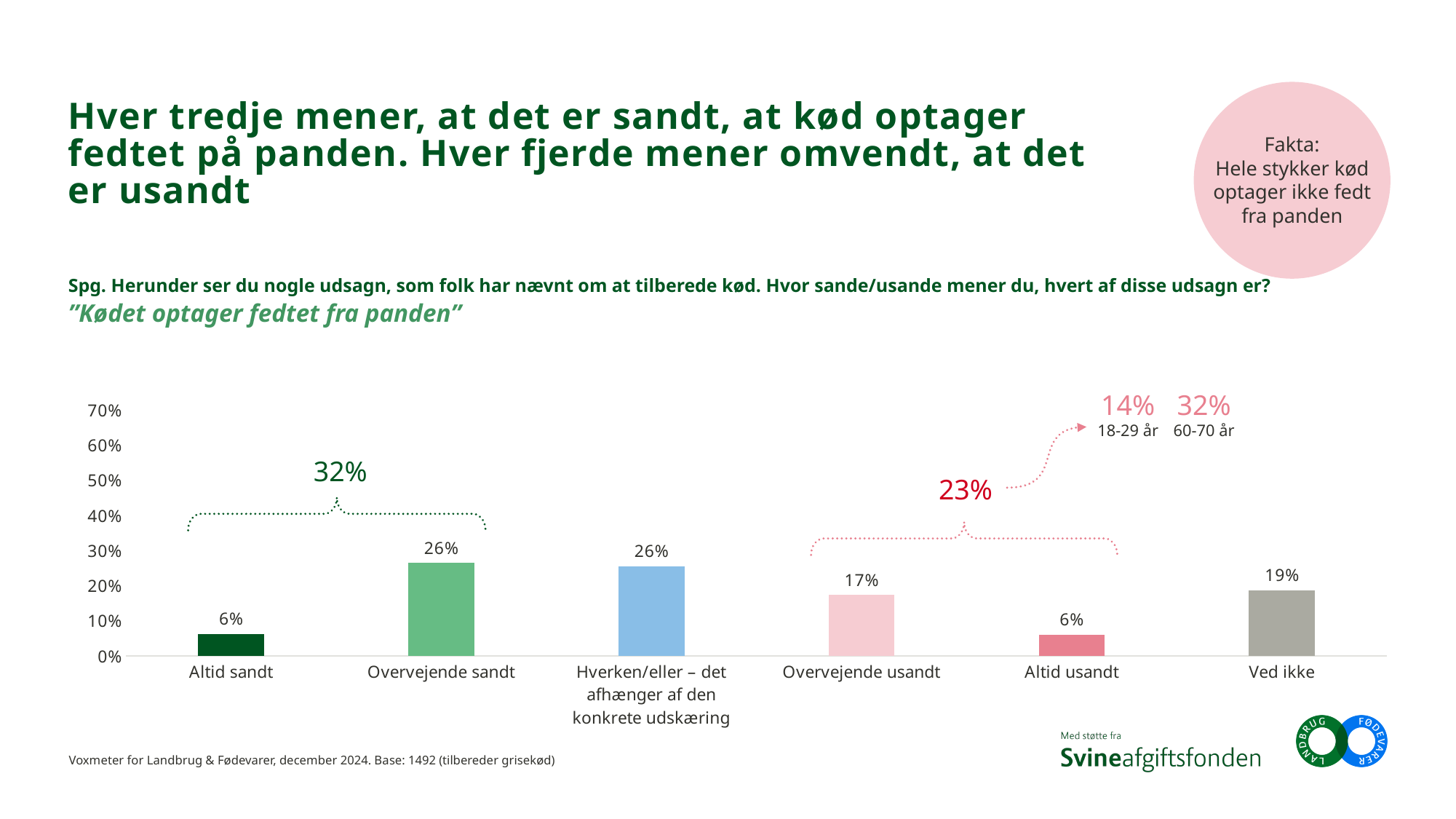
How many categories are shown on the x axis of the chart? 6 What is the value for "Altid sandt"? 6% What is the value for "Altid usandt"? 6% What is the difference between the values for "Ved ikke" and "Overvejende usandt"? 2 percentage points What is the combined value of "Altid sandt" and "Overvejende sandt" as shown by the bracket annotation? 32% Which is larger, the value for "Ved ikke" or the value for "Overvejende usandt"? Ved ikke What is the value for "Overvejende sandt"? 26% Is the value for "Overvejende usandt" greater or less than 20%? less What is the value for "Overvejende usandt"? 17% What is the value for "Ved ikke"? 19% According to the annotation above the "usandt" bars, what share of 60-70 år respondents is shown? 32% What kind of chart is shown on the slide? bar chart